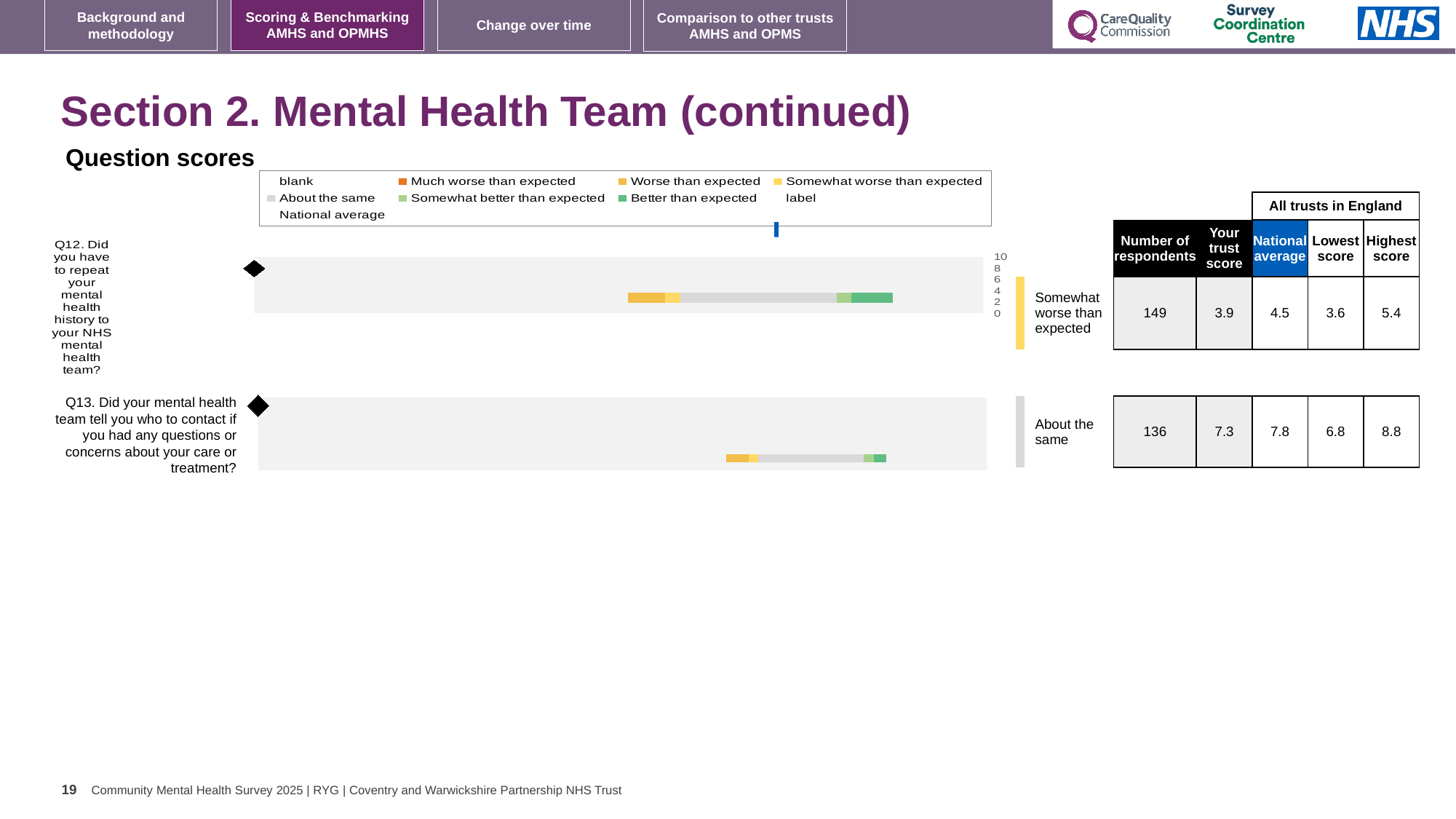
How many questions are plotted on this slide? 2 For Q13, which is larger: the trust's score or the national average? National average What benchmark rating is given to the trust for Q12? Somewhat worse than expected What is the difference between the highest and lowest scores for Q12 across all trusts in England? 1.8 How many respondents are shown for Q13 (told who to contact with questions or concerns)? 136 For Q12 (repeating mental health history), how many respondents are shown in the table? 149 What kind of chart is used to show the question scores? Bar chart What is the lowest score among all trusts in England for Q13? 6.8 What is the highest score among all trusts in England for Q12? 5.4 What is the trust's score for Q12 (repeating mental health history)? 3.9 What is the national average score for Q12 (repeating mental health history)? 4.5 What is the trust's score for Q13 (told who to contact with questions or concerns)? 7.3